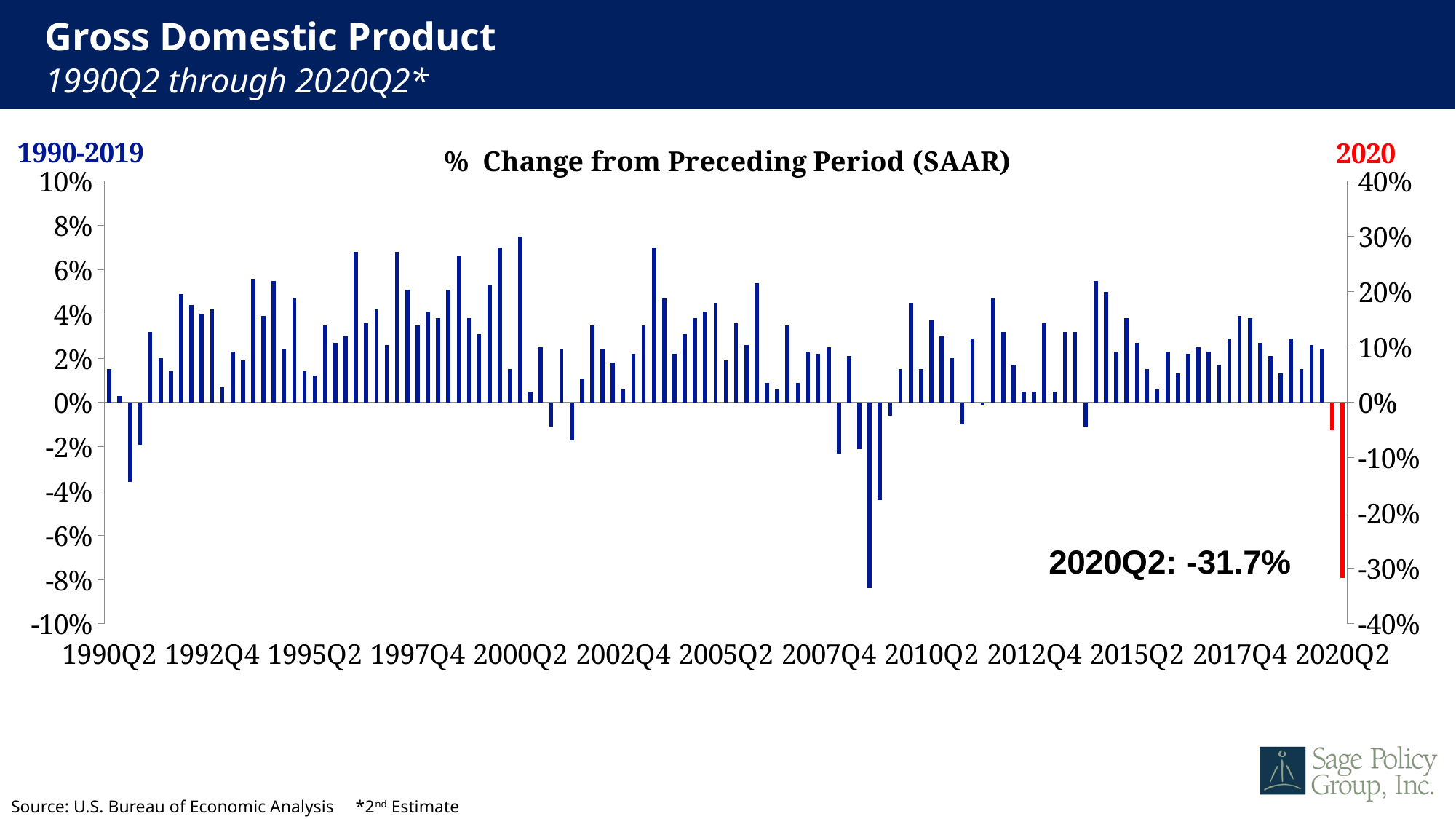
What kind of chart is shown on the slide? bar chart How many series does the chart distinguish (by the labels above the axes)? 2 What is the value shown for 2020Q2? -31.7% Is the value for 2020Q1 greater or less than -10%? greater Is the value for 2020Q2 greater or less than -30%? less Which is lower, the value for 2020Q1 or the value for 2020Q2? 2020Q2 What colour are the bars for the 2020 series? red Which quarter has the lowest value in the chart? 2020Q2 What is the title of the chart? % Change from Preceding Period (SAAR)